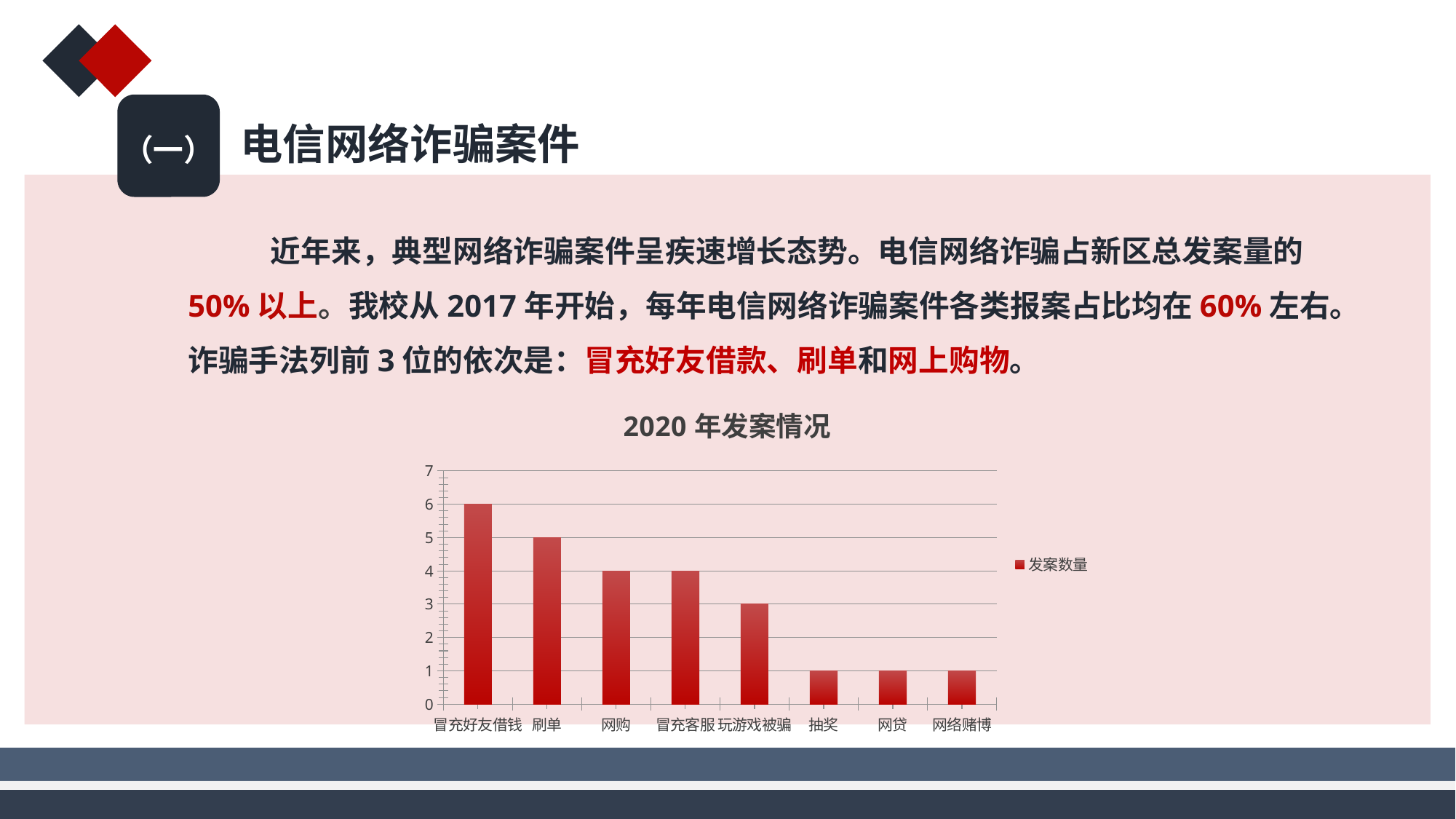
What is the value for 玩游戏被骗 in the 2020 年发案情况 chart? 3 How many categories are shown on the x axis of the 2020 年发案情况 chart? 8 What is the value for 刷单 in the 2020 年发案情况 chart? 5 What is the value for 冒充好友借钱 in the 2020 年发案情况 chart? 6 What is the title of the chart on the slide? 2020 年发案情况 Is the value for 冒充客服 greater or less than 3? greater Which is larger, the value for 网购 or the value for 玩游戏被骗? 网购 How many series does the legend list? 1 What kind of chart is shown on the slide? bar chart What is the difference between the values for 冒充好友借钱 and 刷单? 1 Which category has the highest value in the 2020 年发案情况 chart? 冒充好友借钱 What is the difference between the values for 刷单 and 抽奖? 4